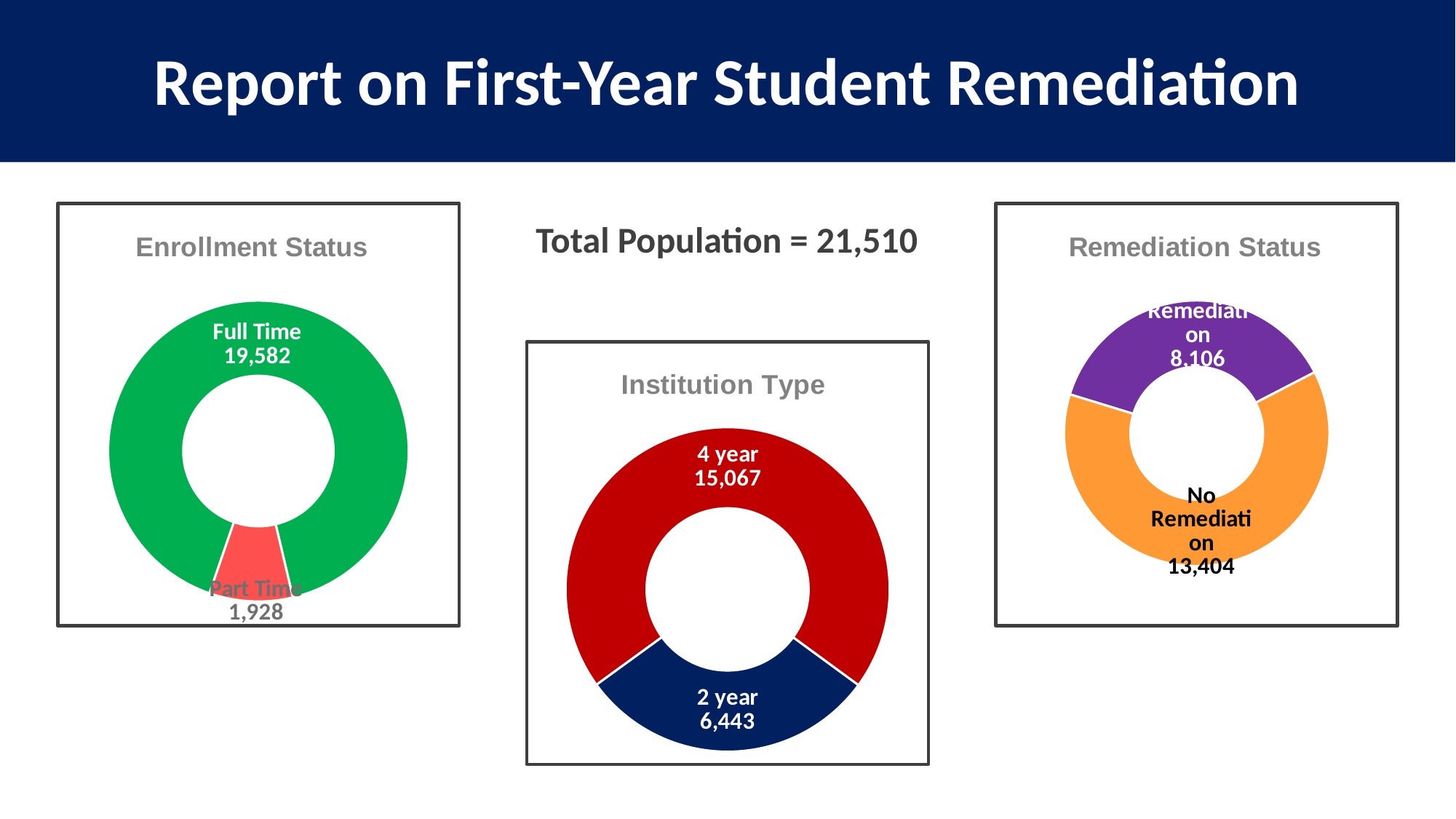
In the Institution Type chart, how much larger is the 4 year value than the 2 year value? 8,624 In the Enrollment Status chart, how many students are Full Time? 19,582 In the Remediation Status chart, which category has the smaller value? Remediation How many charts are shown on the slide? 3 In the Enrollment Status chart, how many students are Part Time? 1,928 In the Institution Type chart, what is the value for 2 year institutions? 6,443 What kind of chart is the Remediation Status chart? Doughnut chart In the Remediation Status chart, how many students had No Remediation? 13,404 In the Enrollment Status chart, what is the difference between Full Time and Part Time? 17,654 In the Institution Type chart, which category has the larger value? 4 year In the Remediation Status chart, what is the difference between No Remediation and Remediation? 5,298 In the Institution Type chart, what is the total of the 4 year and 2 year values? 21,510